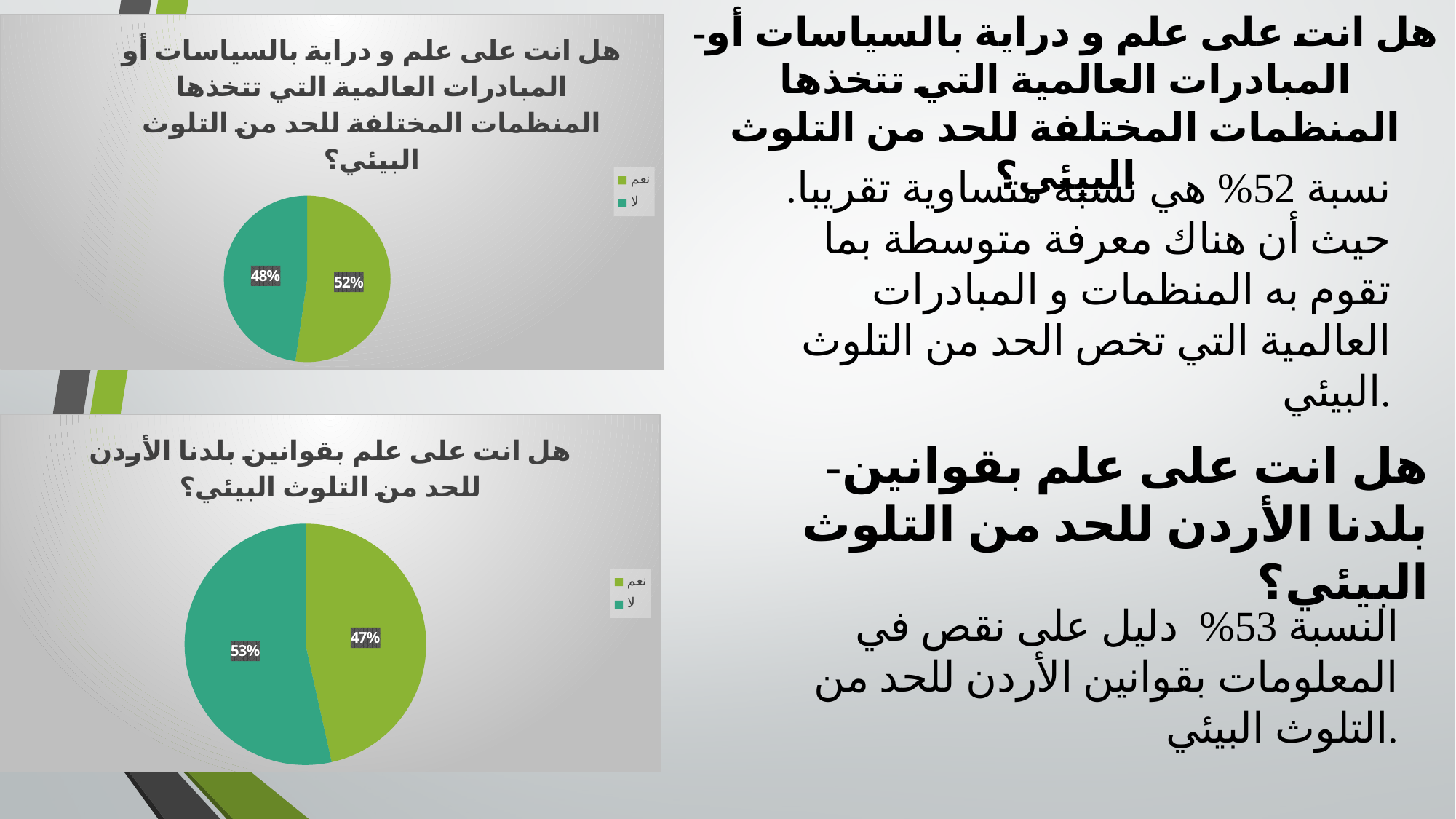
In the top pie chart, what is the difference between the نعم and لا slices? 4% What kind of chart is the top chart on the slide? pie chart How many entries does the legend of the bottom pie chart list? 2 How many slices does the top pie chart have? 2 In the top pie chart, what is the value for لا? 48% In the bottom pie chart, what is the value for نعم? 47% In the bottom pie chart, what is the difference between the لا and نعم slices? 6% In the bottom pie chart, which slice is the largest? لا In the bottom pie chart, what is the value for لا? 53% In the top pie chart, which slice is larger, نعم or لا? نعم In the bottom pie chart, which colour represents نعم? green In the top pie chart, what is the value for نعم? 52%